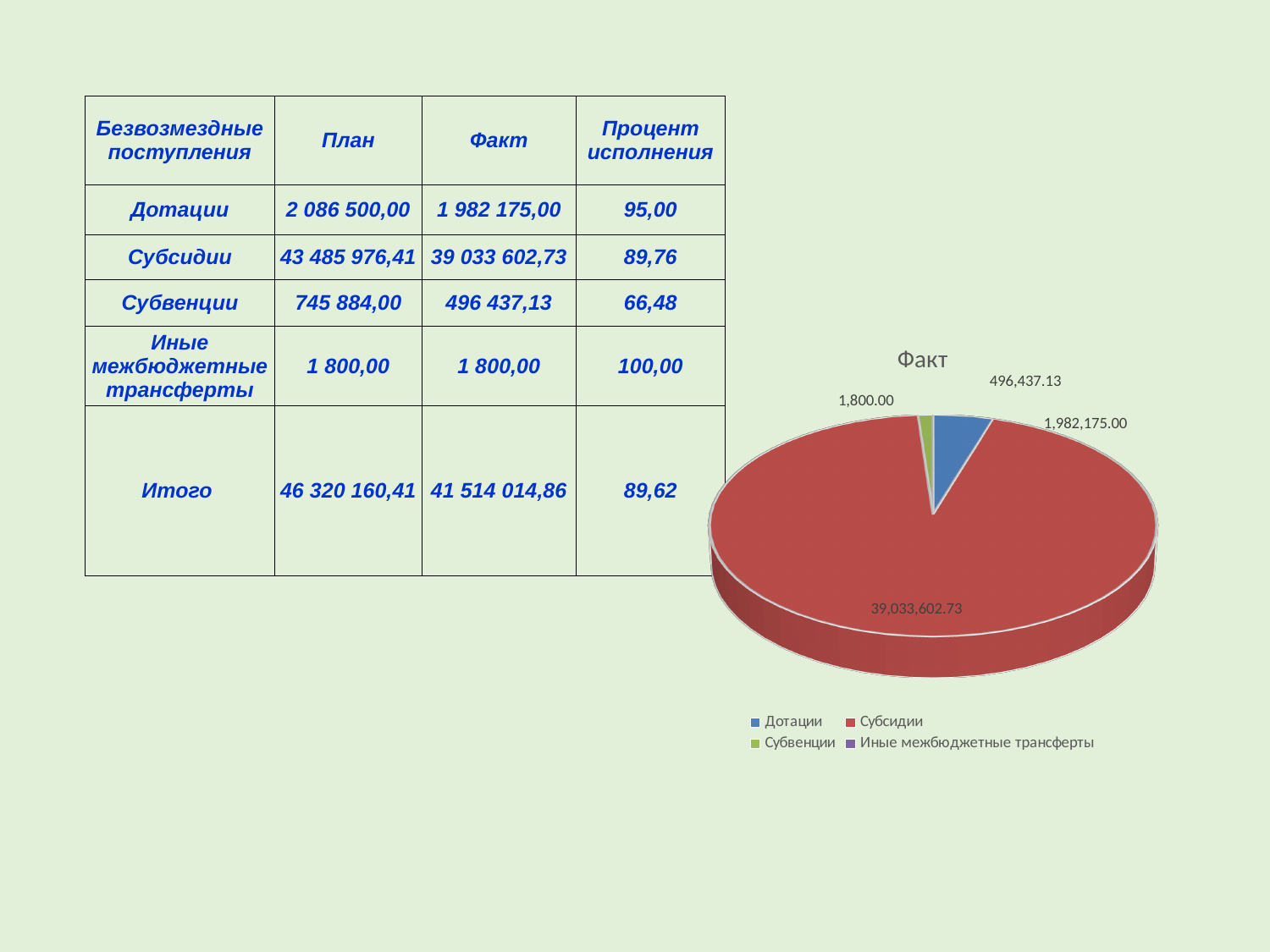
In the pie chart, which is larger: Дотации or Субвенции? Дотации What is the title of the pie chart? Факт In the pie chart, what is the value for Субсидии? 39,033,602.73 Which category has the smallest slice in the pie chart? Иные межбюджетные трансферты In the pie chart, what is the value for Субвенции? 496,437.13 Which category has the largest slice in the pie chart? Субсидии In the pie chart, what is the value for Дотации? 1,982,175.00 In the pie chart, what is the difference between the values for Дотации and Субвенции? 1,485,737.87 What kind of chart is shown on the slide? pie chart How many categories does the pie chart legend list? 4 What colour is the Субсидии slice in the pie chart? red In the pie chart, what is the value for Иные межбюджетные трансферты? 1,800.00